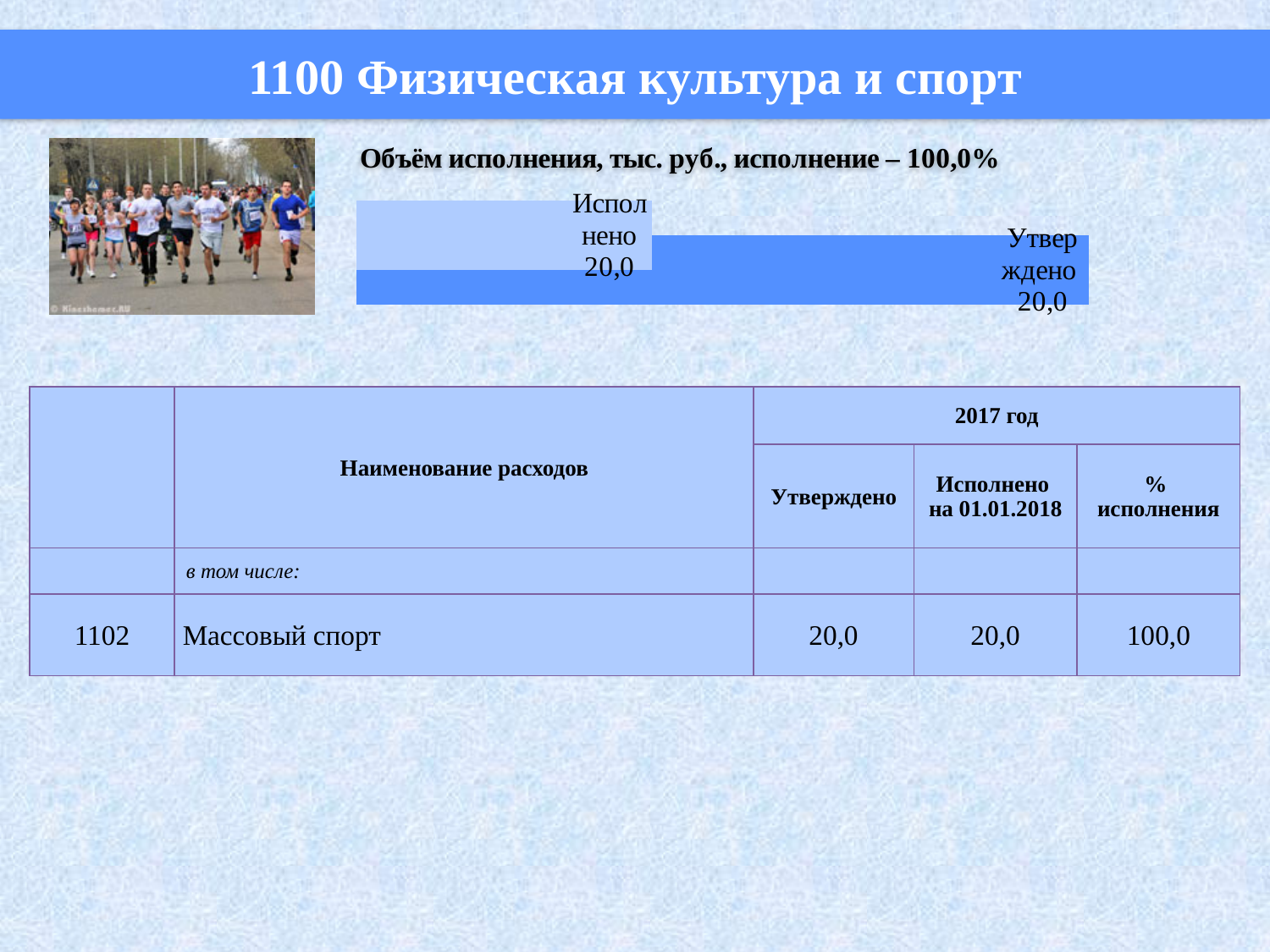
Which bar in the chart is drawn in the darker blue colour? Утверждено What is the title of the chart? Объём исполнения, тыс. руб., исполнение – 100,0% What value is shown for Утверждено in the chart? 20,0 How many bars does the chart contain? 2 What kind of chart is shown on the slide? bar chart What is the difference between the Утверждено and Исполнено values in the chart? 0,0 What value is shown for Исполнено in the chart? 20,0